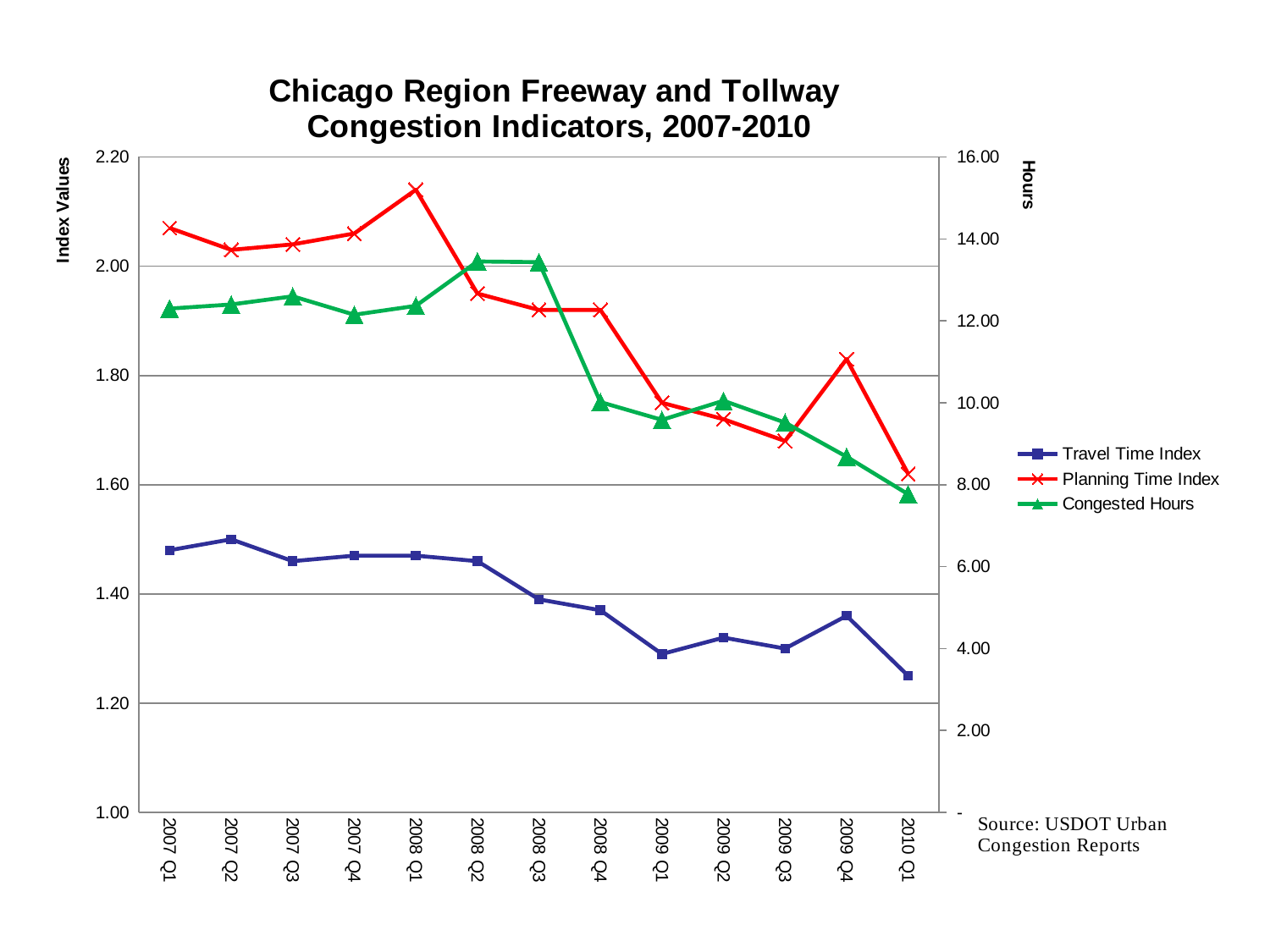
In which quarter is the Planning Time Index at its lowest? 2010 Q1 In which quarter is the Travel Time Index at its lowest? 2010 Q1 Does the Travel Time Index generally rise or fall from 2007 Q1 to 2010 Q1? Fall How many quarters are plotted along the x axis? 13 Is the value for Congested Hours in 2010 Q1 greater or less than 10.00? less Is the Travel Time Index for 2010 Q1 greater or less than 1.40? less Is the value for Congested Hours in 2008 Q3 greater or less than 12.00? greater How many series does the legend list? 3 What kind of chart is shown on the slide? Line chart In which quarter does the Planning Time Index reach its highest value? 2008 Q1 In 2007 Q1, which is higher: the Planning Time Index or the Travel Time Index? Planning Time Index